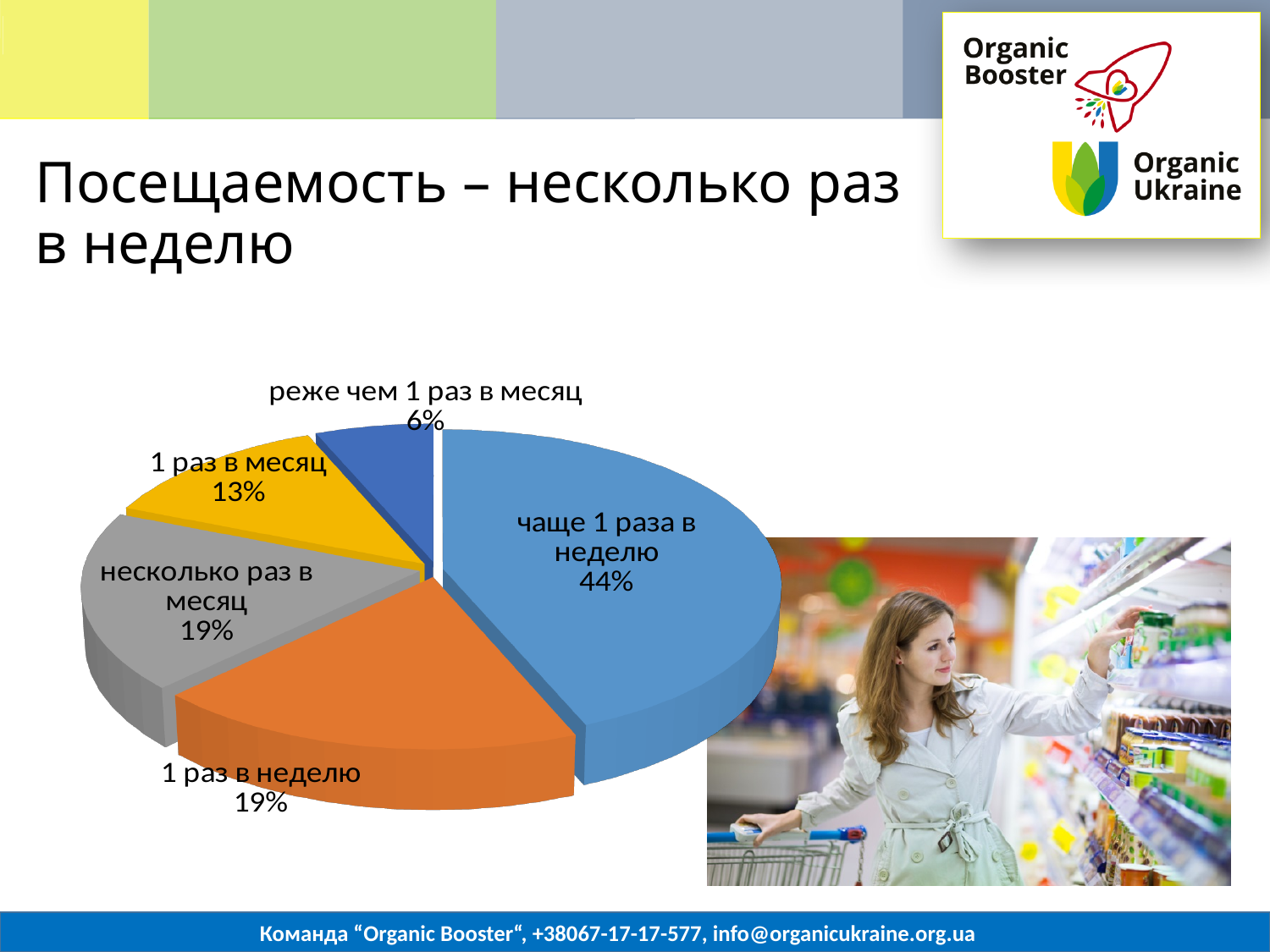
How many slices does the pie chart have? 5 What is the difference between the shares for "чаще 1 раза в неделю" and "1 раз в неделю"? 25% What is the value shown for "1 раз в месяц"? 13% What is the value shown for "несколько раз в месяц"? 19% What is the combined share of "1 раз в неделю" and "несколько раз в месяц"? 38% Which is larger, the share for "1 раз в месяц" or the share for "реже чем 1 раз в месяц"? 1 раз в месяц Which category has the smallest share of the pie? реже чем 1 раз в месяц What share of the pie is labelled "чаще 1 раза в неделю"? 44% What is the value shown for "реже чем 1 раз в месяц"? 6% What colour is the slice for "1 раз в неделю"? orange What kind of chart is shown on the slide? pie chart Which category has the largest share of the pie? чаще 1 раза в неделю